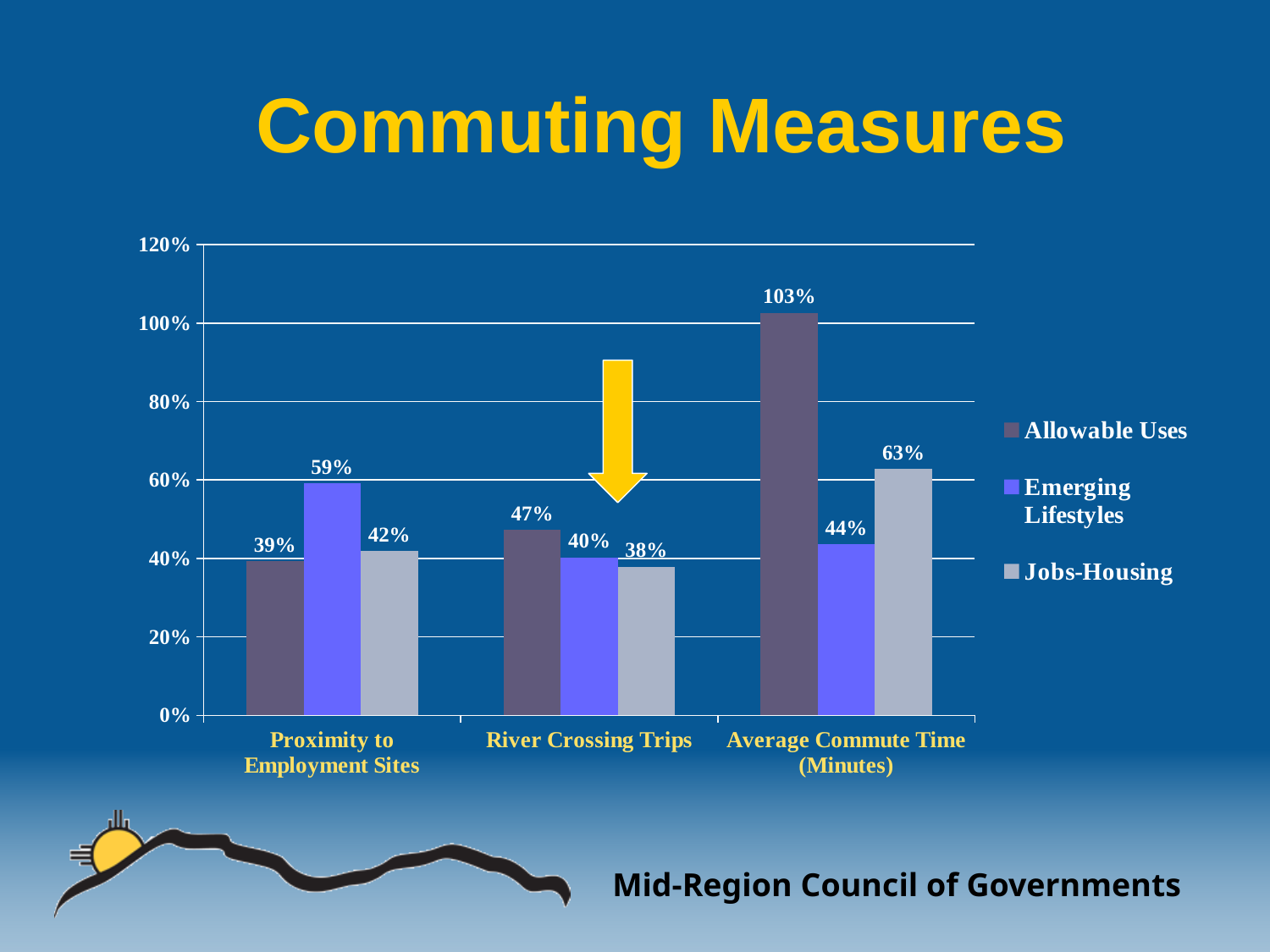
What is the value for Jobs-Housing in the River Crossing Trips category? 38% How many categories are shown on the x axis? 3 Which series has the lowest value in the Proximity to Employment Sites category? Allowable Uses What is the difference between the Jobs-Housing and Emerging Lifestyles values in the Average Commute Time (Minutes) category? 19% How many series does the legend list? 3 Is the value for Allowable Uses in the Average Commute Time (Minutes) category greater or less than 100%? greater What is the title of the slide containing the chart? Commuting Measures What is the value for Allowable Uses in the Average Commute Time (Minutes) category? 103% Which series has the highest value in the Average Commute Time (Minutes) category? Allowable Uses What is the value for Emerging Lifestyles in the Proximity to Employment Sites category? 59% Which is larger in the River Crossing Trips category: Allowable Uses or Emerging Lifestyles? Allowable Uses What kind of chart is shown on the slide? bar chart